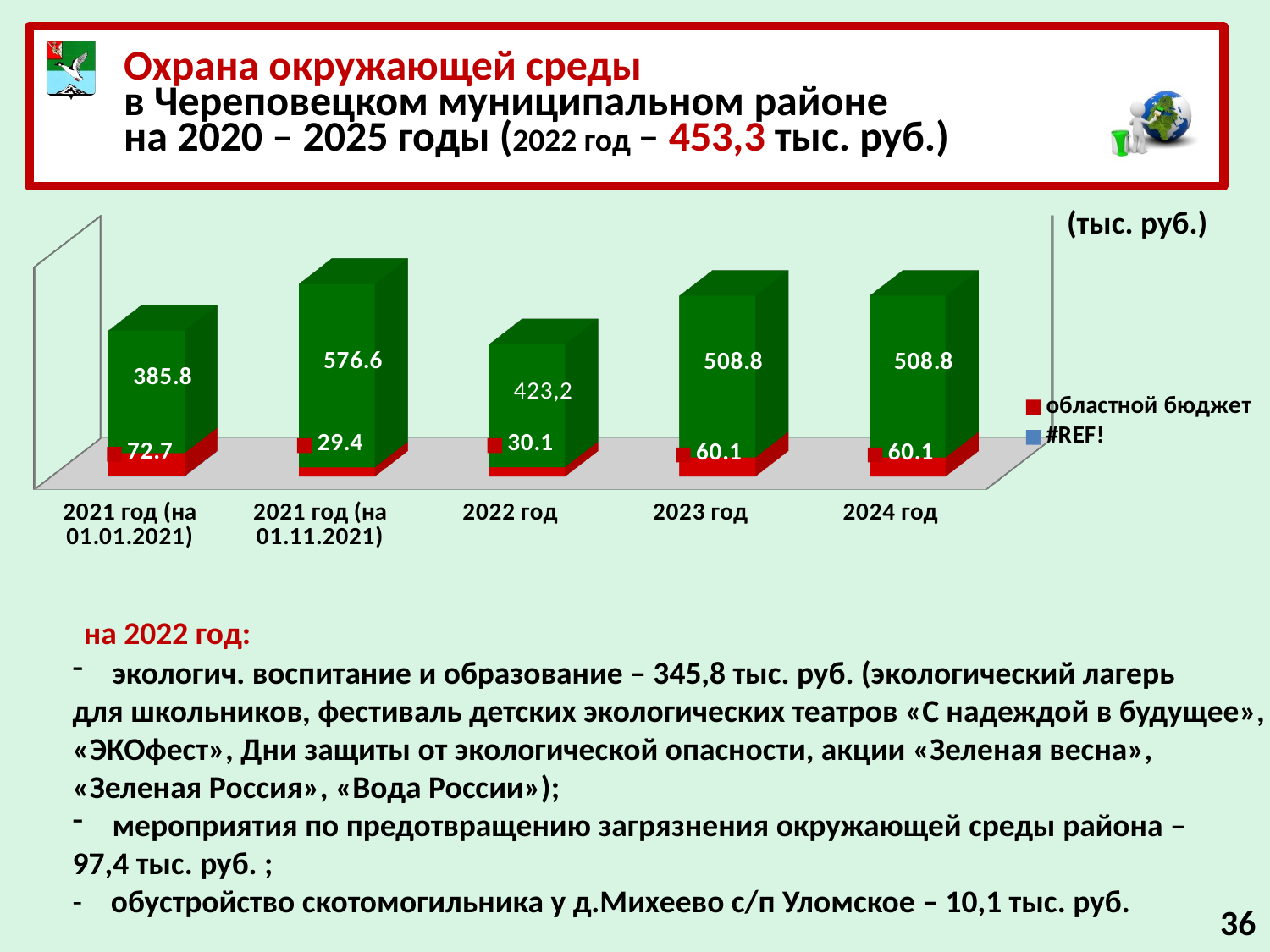
Which category has the highest green segment value? 2021 год (на 01.11.2021) Which is larger: the областной бюджет value for 2021 год (на 01.01.2021) or for 2024 год? 2021 год (на 01.01.2021) What type of chart is shown on the slide? Stacked bar chart What is the value of the green segment for 2022 год? 423,2 What is the value of the green segment for 2021 год (на 01.11.2021)? 576.6 Which category has the lowest областной бюджет value? 2021 год (на 01.11.2021) What is the value of the red (областной бюджет) segment for 2021 год (на 01.01.2021)? 72.7 How many series does the chart legend list? 2 What is the total of the stacked bar for 2022 год? 453.3 How many categories are shown on the x axis of the chart? 5 What is the value of the областной бюджет segment for 2023 год? 60.1 What is the difference between the green segment values for 2021 год (на 01.11.2021) and 2021 год (на 01.01.2021)? 190.8